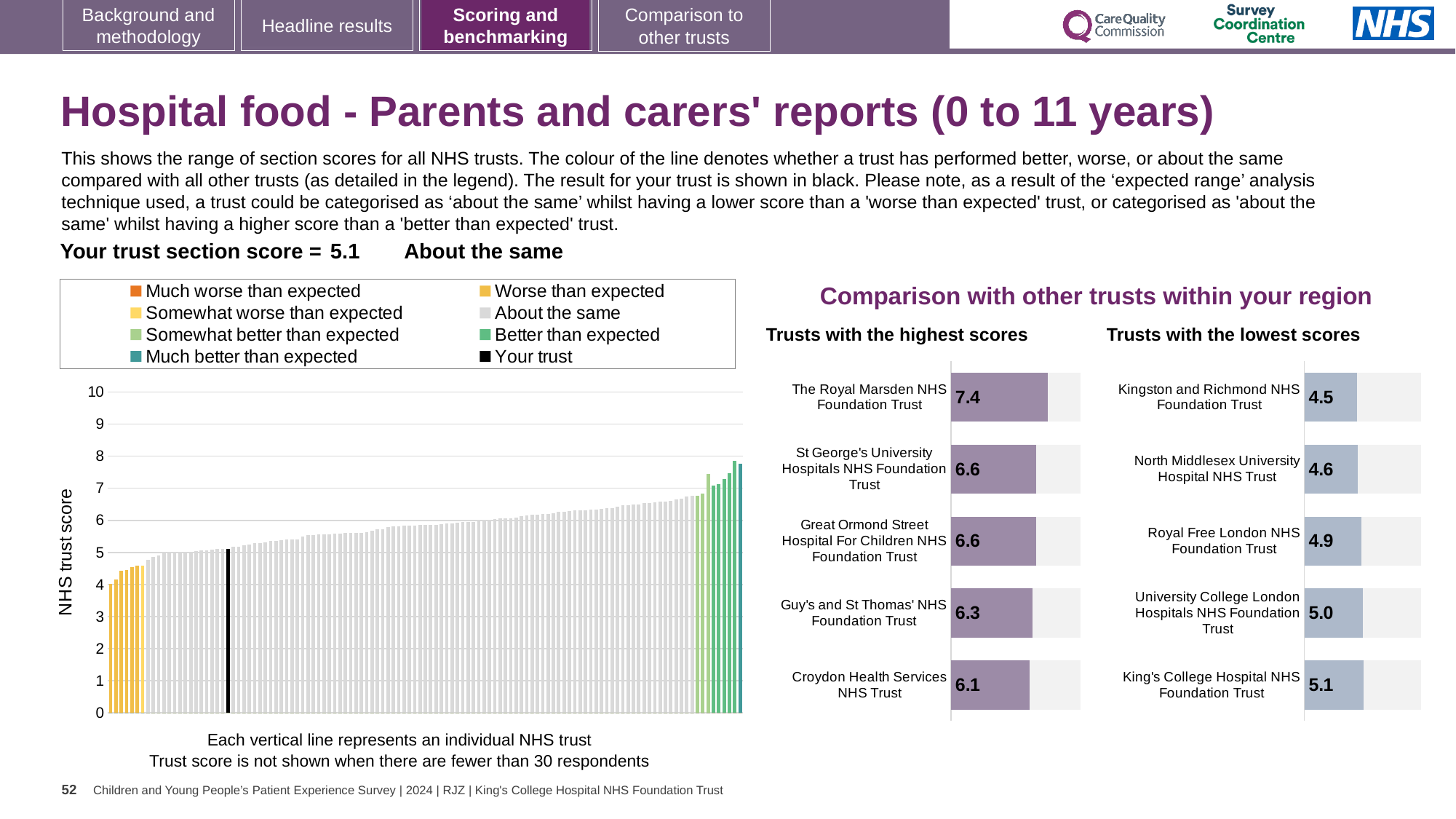
How many entries does the legend of the large chart on the left list? 8 In the 'Trusts with the lowest scores' chart, which has the larger score: Royal Free London NHS Foundation Trust or North Middlesex University Hospital NHS Trust? Royal Free London NHS Foundation Trust What kind of chart is the large chart on the left showing all NHS trusts? Bar chart In the 'Trusts with the highest scores' chart, what is the difference between the scores of The Royal Marsden NHS Foundation Trust and Croydon Health Services NHS Trust? 1.3 In the large chart on the left, do the trust scores rise or fall from left to right? Rise In the 'Trusts with the lowest scores' chart, what is the score for Kingston and Richmond NHS Foundation Trust? 4.5 In the 'Trusts with the lowest scores' chart, what is the difference between the scores of King's College Hospital NHS Foundation Trust and Kingston and Richmond NHS Foundation Trust? 0.6 In the 'Trusts with the lowest scores' chart, which trust has the lowest score? Kingston and Richmond NHS Foundation Trust In the 'Trusts with the highest scores' chart, how many trusts are shown? 5 In the 'Trusts with the highest scores' chart, what is the score for Croydon Health Services NHS Trust? 6.1 In the 'Trusts with the highest scores' chart, what is the score for The Royal Marsden NHS Foundation Trust? 7.4 In the 'Trusts with the highest scores' chart, which trust has the highest score? The Royal Marsden NHS Foundation Trust